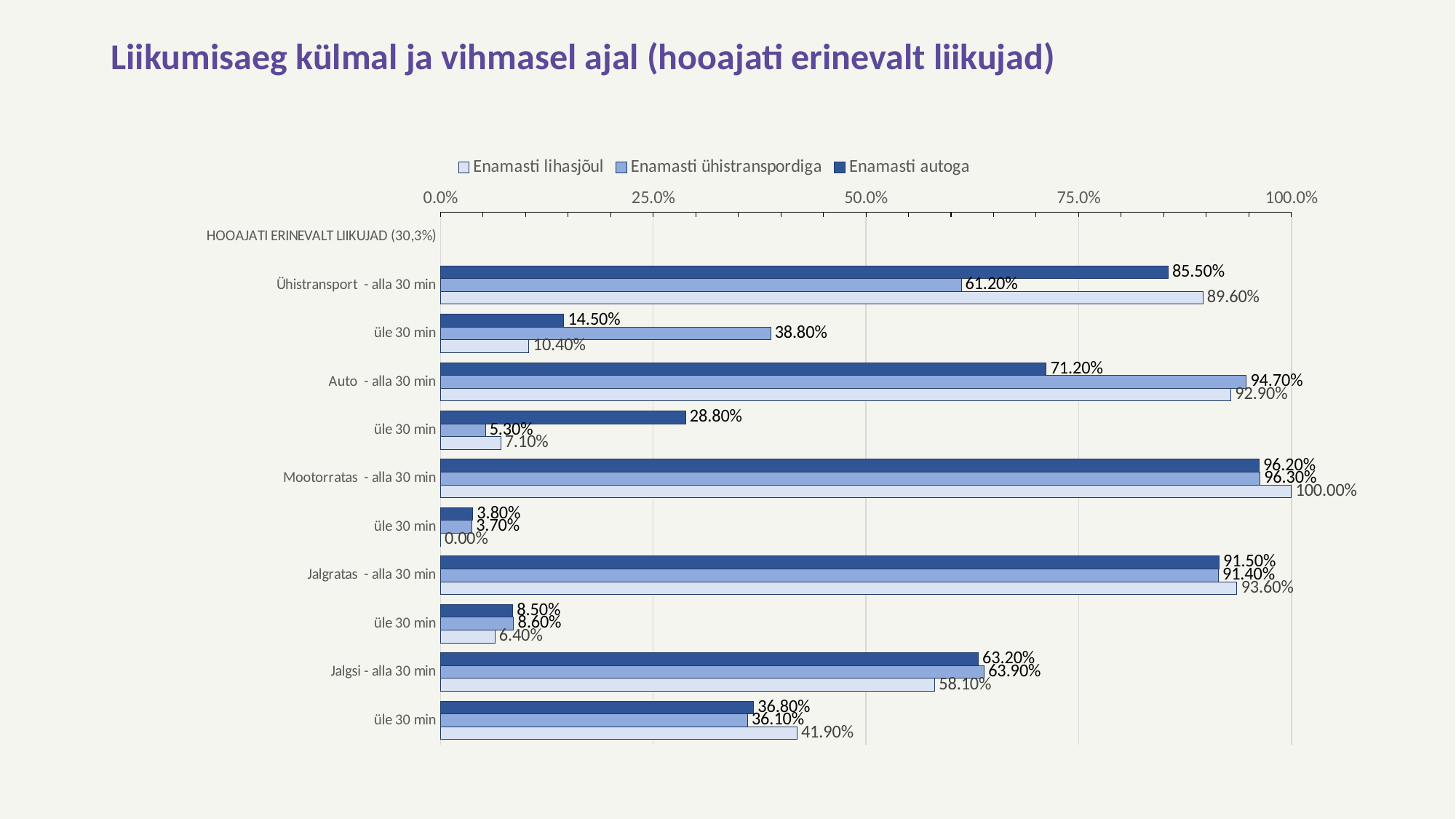
What kind of chart is shown on the slide? bar chart What is the value of Enamasti autoga for the üle 30 min row under Auto? 28.80% Which series has the lowest value for the üle 30 min row under Mootorratas? Enamasti lihasjõul For the üle 30 min row under Jalgsi, which is larger: Enamasti lihasjõul or Enamasti autoga? Enamasti lihasjõul What is the value of Enamasti autoga for Ühistransport - alla 30 min? 85.50% What is the value of Enamasti ühistranspordiga for the üle 30 min row under Ühistransport? 38.80% How many series does the legend list? 3 What is the value of Enamasti lihasjõul for Mootorratas - alla 30 min? 100.00% Which series has the highest value for Auto - alla 30 min? Enamasti ühistranspordiga What is the value of Enamasti lihasjõul for Jalgsi - alla 30 min? 58.10% What is the difference between Enamasti lihasjõul and Enamasti ühistranspordiga for Ühistransport - alla 30 min? 28.40% Which series is shown with the darkest blue bars? Enamasti autoga